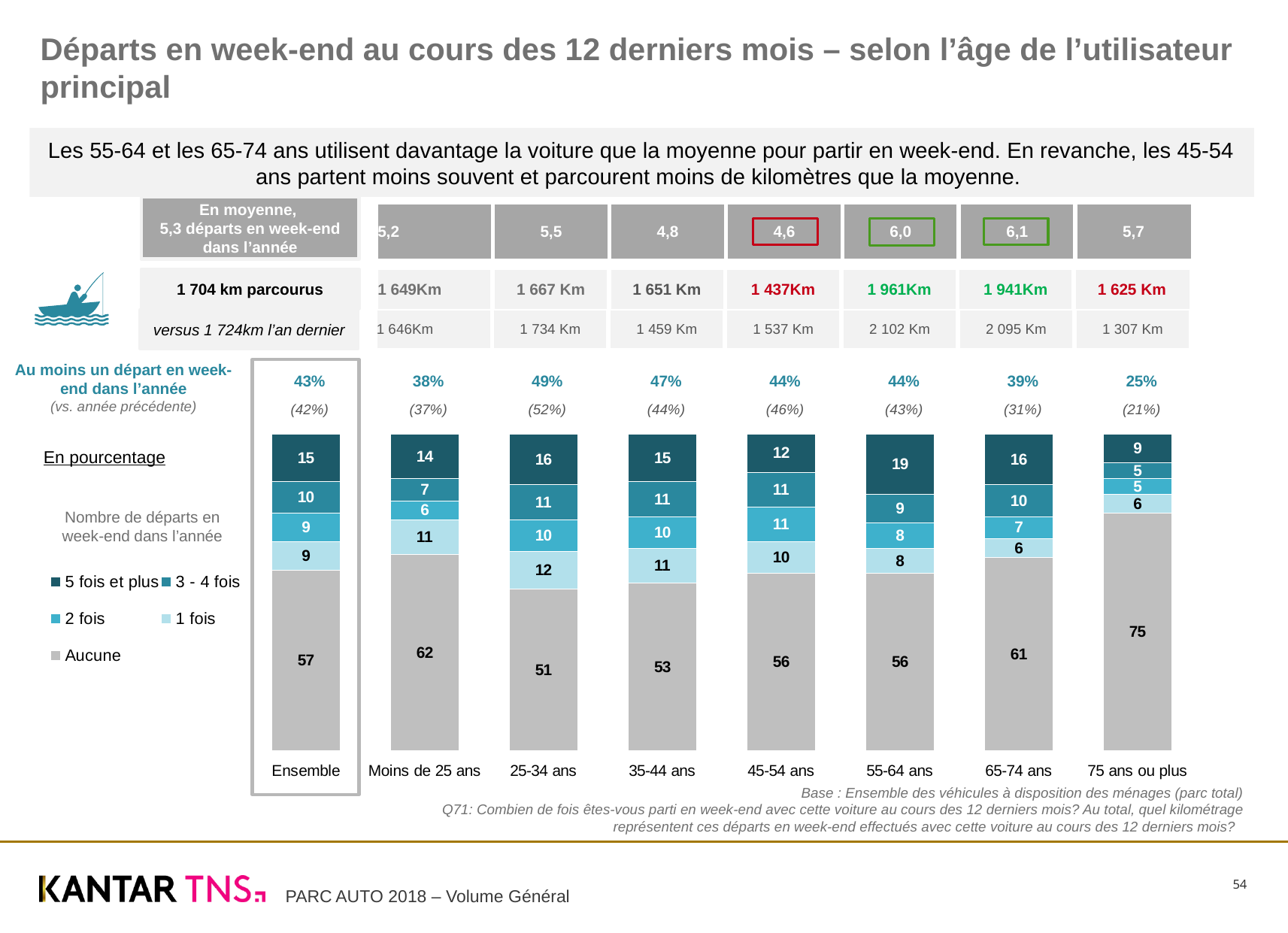
What is the value of 'Aucune' for the 75 ans ou plus category? 75 What kind of chart is shown on the slide? Stacked bar chart Which category has the lowest 'Aucune' value? 25-34 ans Which series in the legend is shown in light grey? Aucune What is the difference between the 'Aucune' values for Moins de 25 ans and Ensemble? 5 How many series does the chart legend list? 5 How many age categories (including Ensemble) are plotted in the chart? 8 Which is larger: the '5 fois et plus' value for 65-74 ans or for 45-54 ans? 65-74 ans Which category has the highest 'Aucune' value? 75 ans ou plus What is the total of the stacked bar for the 35-44 ans category? 100 What is the value of '5 fois et plus' for the 55-64 ans category? 19 What is the value of '1 fois' for the 25-34 ans category? 12